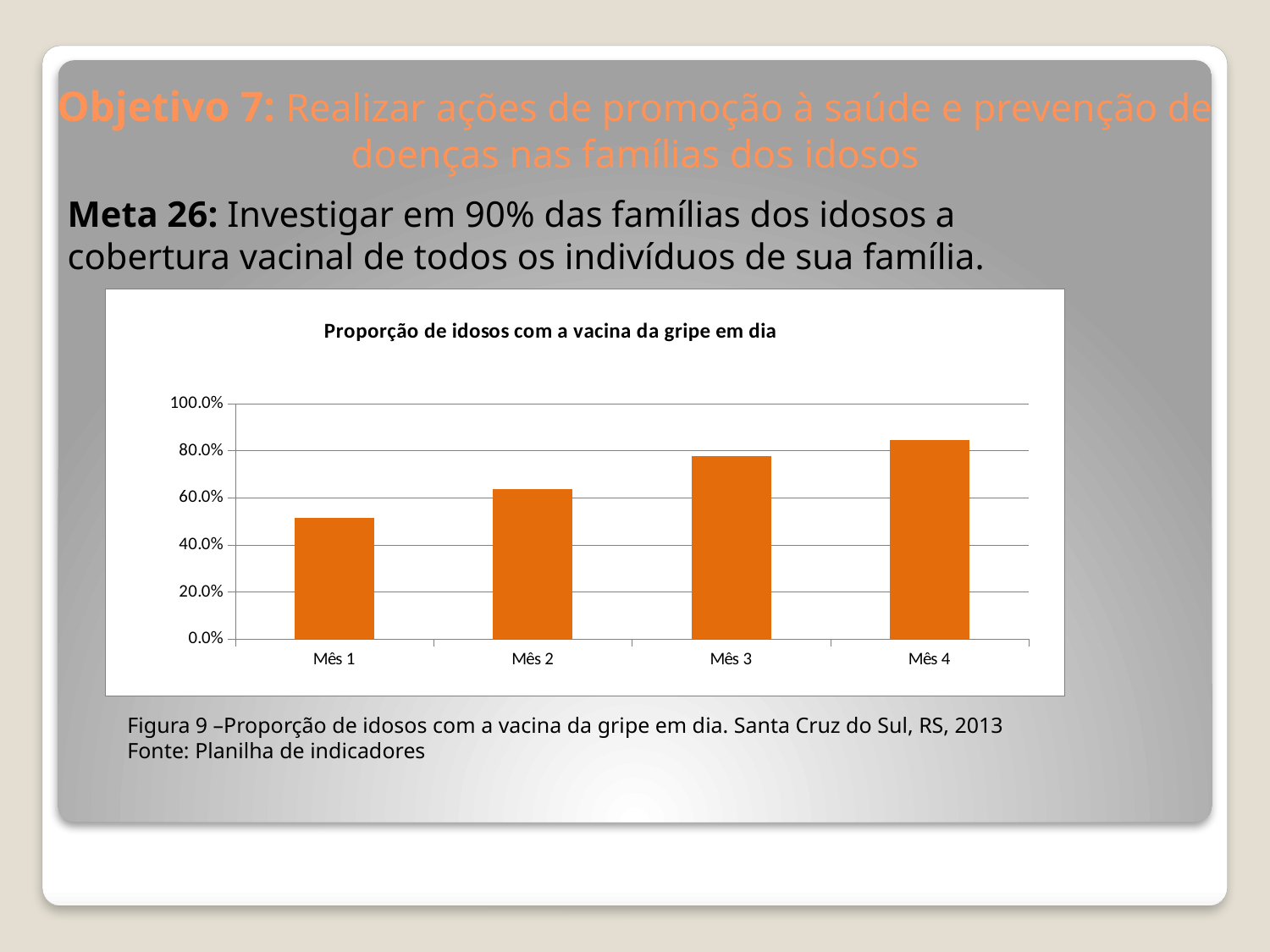
How many categories (months) are shown on the x axis of the chart? 4 Is the value for Mês 2 greater or less than 80.0%? less Is the value for Mês 1 greater or less than 60.0%? less Is the value for Mês 4 greater or less than 80.0%? greater Which month has the lowest proportion of elderly with the flu vaccine up to date? Mês 1 What type of chart is shown on the slide? Bar chart Do the values rise or fall from Mês 1 to Mês 4? Rise Which is larger, the value for Mês 3 or the value for Mês 1? Mês 3 What is the title of the chart? Proporção de idosos com a vacina da gripe em dia Which month has the highest proportion of elderly with the flu vaccine up to date? Mês 4